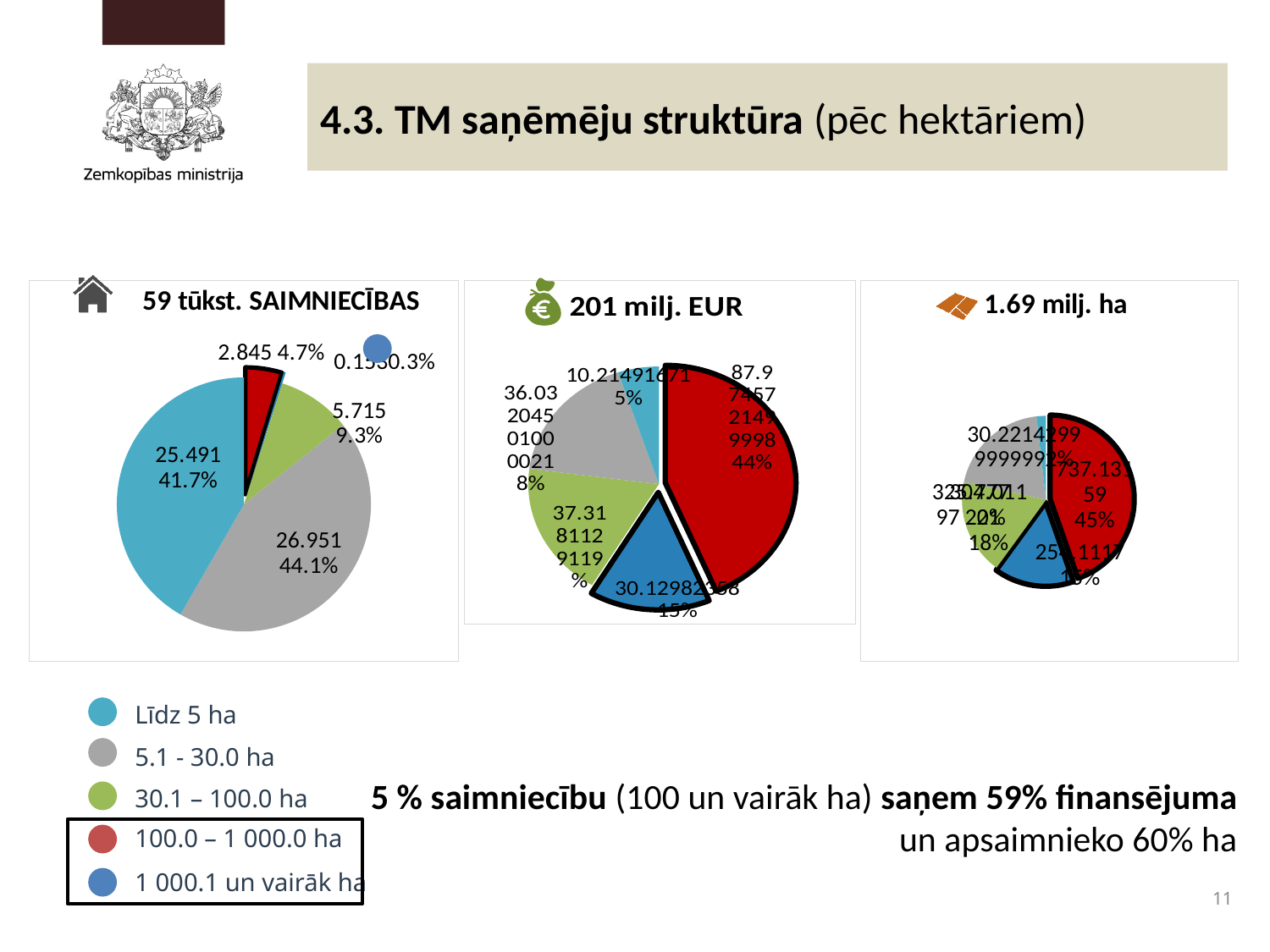
In the "59 tūkst. SAIMNIECĪBAS" chart, what percentage share does the 5.1 - 30.0 ha category have? 44.1% In the "201 milj. EUR" chart, what percentage share does the 100.0 – 1 000.0 ha category (red slice) have? 44% In the "59 tūkst. SAIMNIECĪBAS" chart, what is the value shown for the Līdz 5 ha category? 25.491 In the "1.69 milj. ha" chart, what percentage share does the 100.0 – 1 000.0 ha category (red slice) have? 45% What kind of chart is the "59 tūkst. SAIMNIECĪBAS" chart? pie chart In the "201 milj. EUR" chart, which is larger: the share for Līdz 5 ha or the share for 1 000.1 un vairāk ha? 1 000.1 un vairāk ha In the "59 tūkst. SAIMNIECĪBAS" chart, what is the value shown for the 100.0 – 1 000.0 ha category? 2.845 How many categories does the legend at the bottom of the slide list? 5 In the "59 tūkst. SAIMNIECĪBAS" chart, which category has the largest slice? 5.1 - 30.0 ha In the "59 tūkst. SAIMNIECĪBAS" chart, by how many percentage points does the 5.1 - 30.0 ha share exceed the Līdz 5 ha share? 2.4